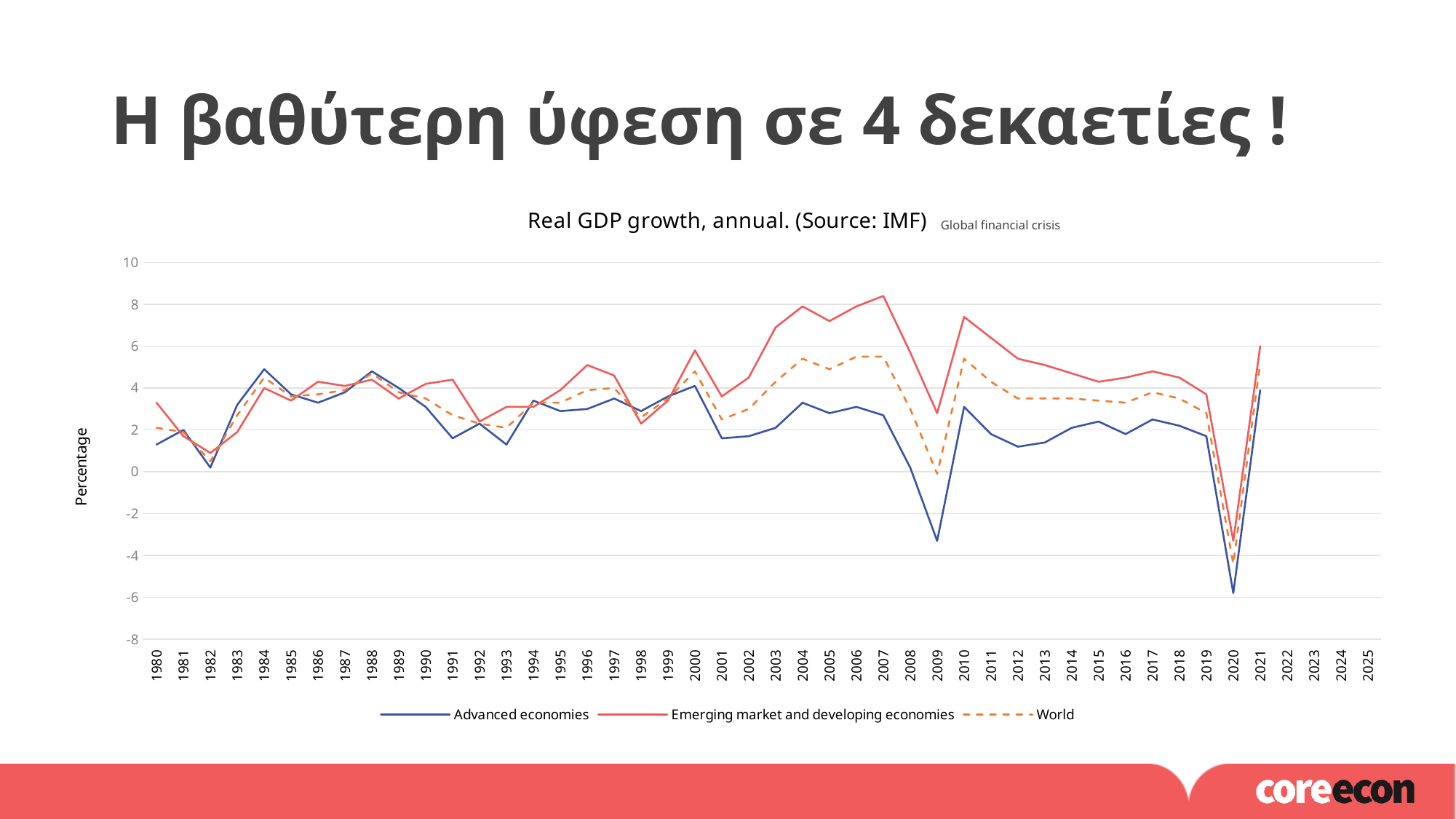
In which year does the Advanced economies series reach its lowest value? 2020 In which year does the Emerging market and developing economies series reach its highest value? 2007 Is the value for Advanced economies in 2009 greater or less than -2? less How many series does the legend list? 3 In 2007, which is larger: the value for Advanced economies or for Emerging market and developing economies? Emerging market and developing economies Is the value for World in 2020 greater or less than -2? less What kind of chart is shown on the slide? line chart Is the value for Emerging market and developing economies in 2007 greater or less than 8? greater Which series has the lowest value in 2020? Advanced economies What label is shown on the vertical axis? Percentage What is the title of the chart? Real GDP growth, annual. (Source: IMF)